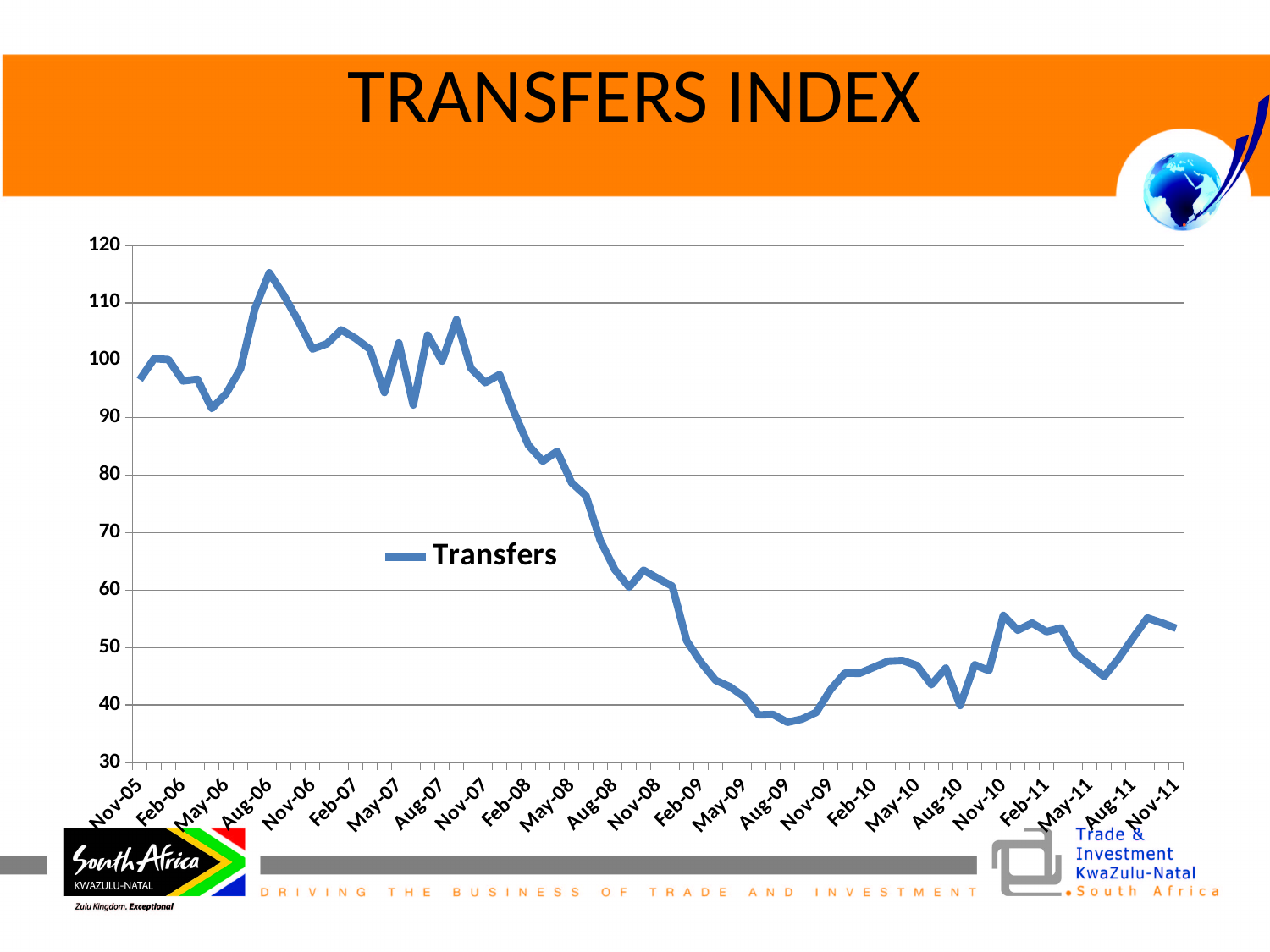
Around which x-axis label does the Transfers line reach its highest point? Aug-06 How many date labels are shown along the x axis? 25 Is the Transfers value at Aug-06 greater or less than 110? greater Is the Transfers value at Aug-09 greater or less than 40? less What is the name of the series shown in the legend? Transfers What is the title of the chart? TRANSFERS INDEX Which is larger, the Transfers value at Nov-05 or at Nov-11? Nov-05 Is the Transfers value at Nov-05 greater or less than 90? greater Overall, does the Transfers line rise or fall from Nov-05 to Nov-11? Fall Around which x-axis label does the Transfers line reach its lowest point? Aug-09 How many series does the legend list? 1 What kind of chart is shown on the slide? Line chart